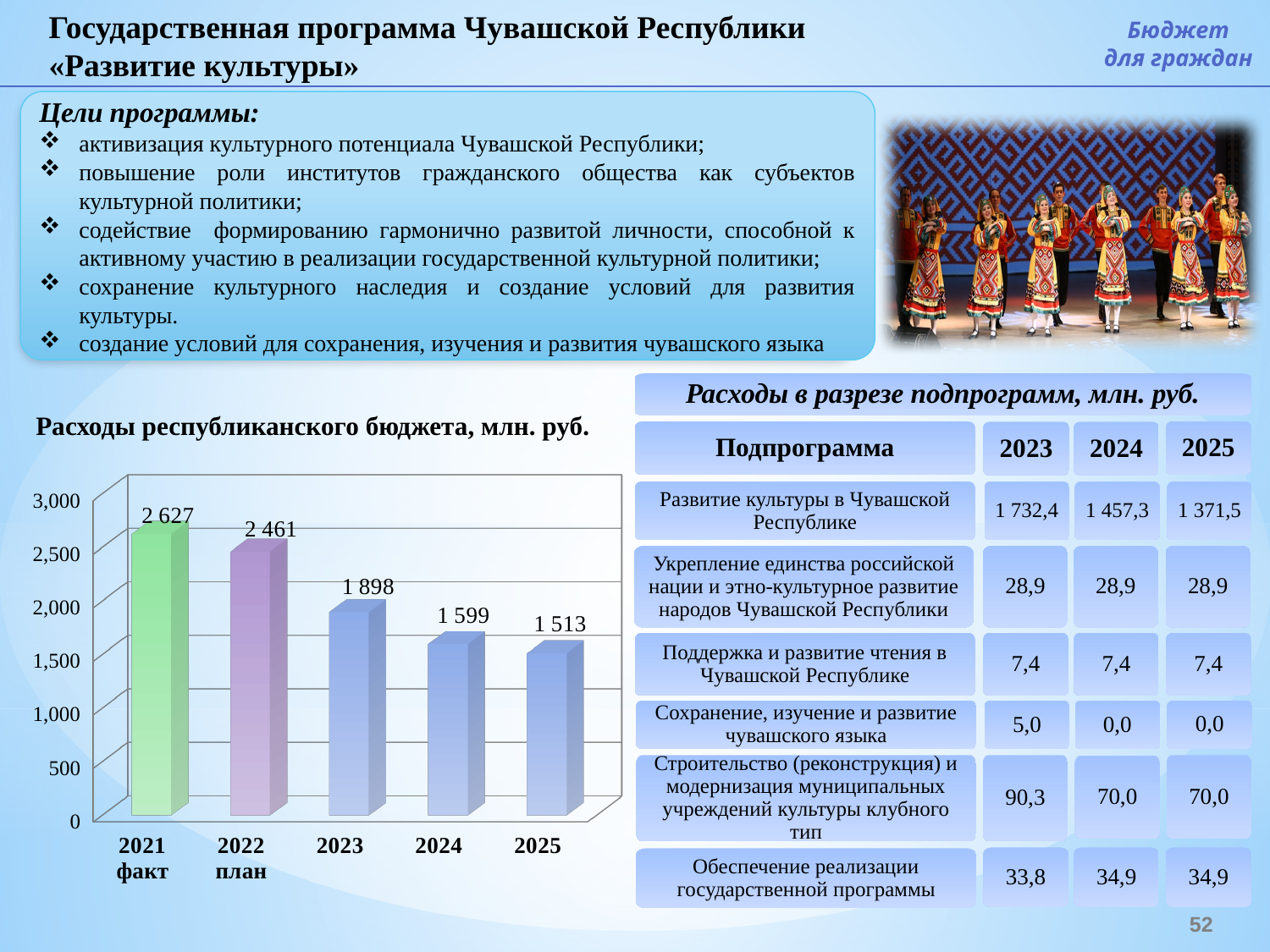
What is the value for 2023 in the chart 'Расходы республиканского бюджета, млн. руб.'? 1 898 Which year has the highest value in the chart 'Расходы республиканского бюджета, млн. руб.'? 2021 факт Which year has the lowest value in the chart 'Расходы республиканского бюджета, млн. руб.'? 2025 Which is larger in the chart 'Расходы республиканского бюджета, млн. руб.': the value for 2022 план or the value for 2023? 2022 план What is the value for 2025 in the chart 'Расходы республиканского бюджета, млн. руб.'? 1 513 Do the values in the chart 'Расходы республиканского бюджета, млн. руб.' rise or fall from 2021 to 2025? fall Is the value for 2024 in the chart 'Расходы республиканского бюджета, млн. руб.' greater or less than 2,000? less What is the difference between the values for 2023 and 2024 in the chart 'Расходы республиканского бюджета, млн. руб.'? 299 What is the value for 2021 факт in the chart 'Расходы республиканского бюджета, млн. руб.'? 2 627 How many years are shown on the x axis of the chart 'Расходы республиканского бюджета, млн. руб.'? 5 What kind of chart is 'Расходы республиканского бюджета, млн. руб.'? bar chart What is the difference between the values for 2021 факт and 2022 план in the chart 'Расходы республиканского бюджета, млн. руб.'? 166